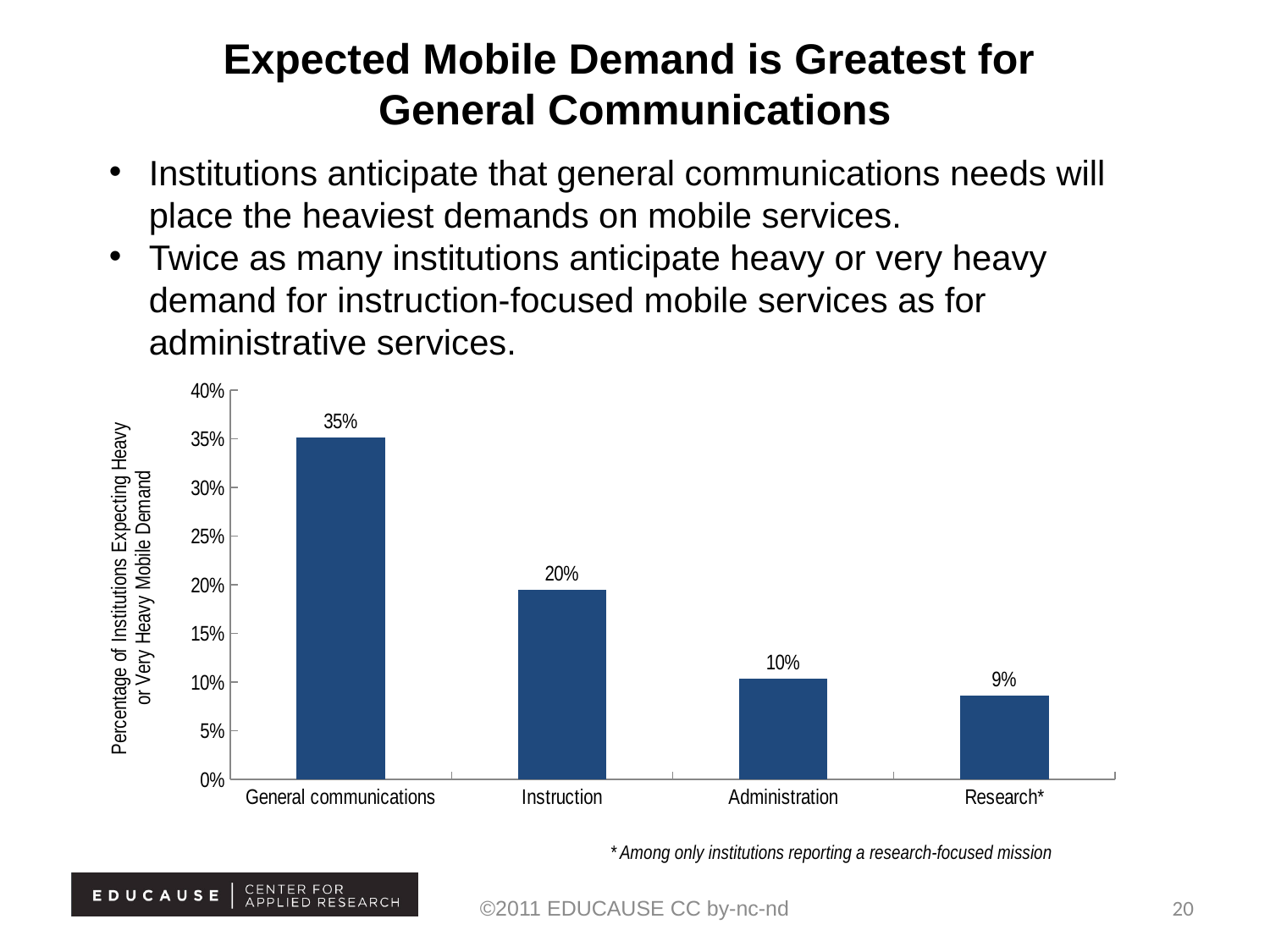
What is the difference between the values for General communications and Instruction? 15% What percentage of institutions expect heavy or very heavy mobile demand for General communications? 35% What kind of chart is shown on the slide? Bar chart What is the difference between the values for Instruction and Administration? 10% What is the value shown for Research*? 9% Which is larger, the value for Instruction or the value for Administration? Instruction How many categories are shown on the x axis of the chart? 4 What is the value shown for Administration? 10% What is the label of the vertical axis of the chart? Percentage of Institutions Expecting Heavy or Very Heavy Mobile Demand What percentage of institutions expect heavy or very heavy mobile demand for Instruction? 20% Which category has the lowest percentage of institutions expecting heavy or very heavy mobile demand? Research* Which category has the highest percentage of institutions expecting heavy or very heavy mobile demand? General communications